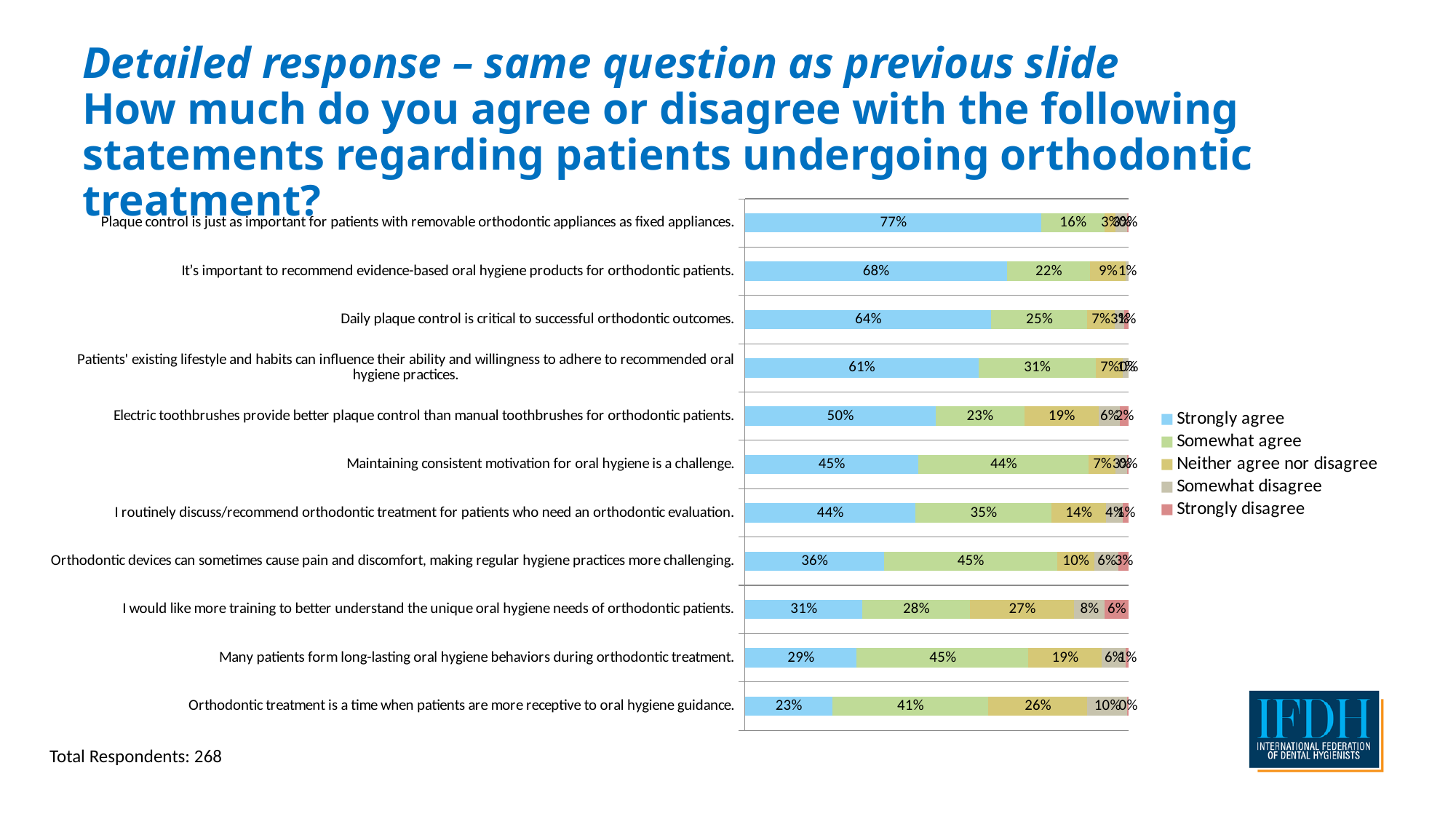
What kind of chart is shown on the slide? Stacked bar chart Which statement has the lowest 'Strongly agree' percentage? Orthodontic treatment is a time when patients are more receptive to oral hygiene guidance. How many statements (categories) are plotted in the chart? 11 What is the 'Strongly disagree' percentage for the statement 'I would like more training to better understand the unique oral hygiene needs of orthodontic patients'? 6% What percentage of respondents strongly agree that plaque control is just as important for patients with removable orthodontic appliances as fixed appliances? 77% What is the difference between the 'Strongly agree' percentages for 'Daily plaque control is critical to successful orthodontic outcomes' and 'Electric toothbrushes provide better plaque control than manual toothbrushes for orthodontic patients'? 14% Which statement has the highest 'Strongly agree' percentage? Plaque control is just as important for patients with removable orthodontic appliances as fixed appliances. What is the 'Neither agree nor disagree' value for the statement 'I would like more training to better understand the unique oral hygiene needs of orthodontic patients'? 27% What percentage of respondents somewhat agree that it's important to recommend evidence-based oral hygiene products for orthodontic patients? 22% For the statement 'Orthodontic devices can sometimes cause pain and discomfort, making regular hygiene practices more challenging', which is larger: 'Strongly agree' or 'Somewhat agree'? Somewhat agree Which legend entry is shown in blue? Strongly agree How many series does the legend list? 5